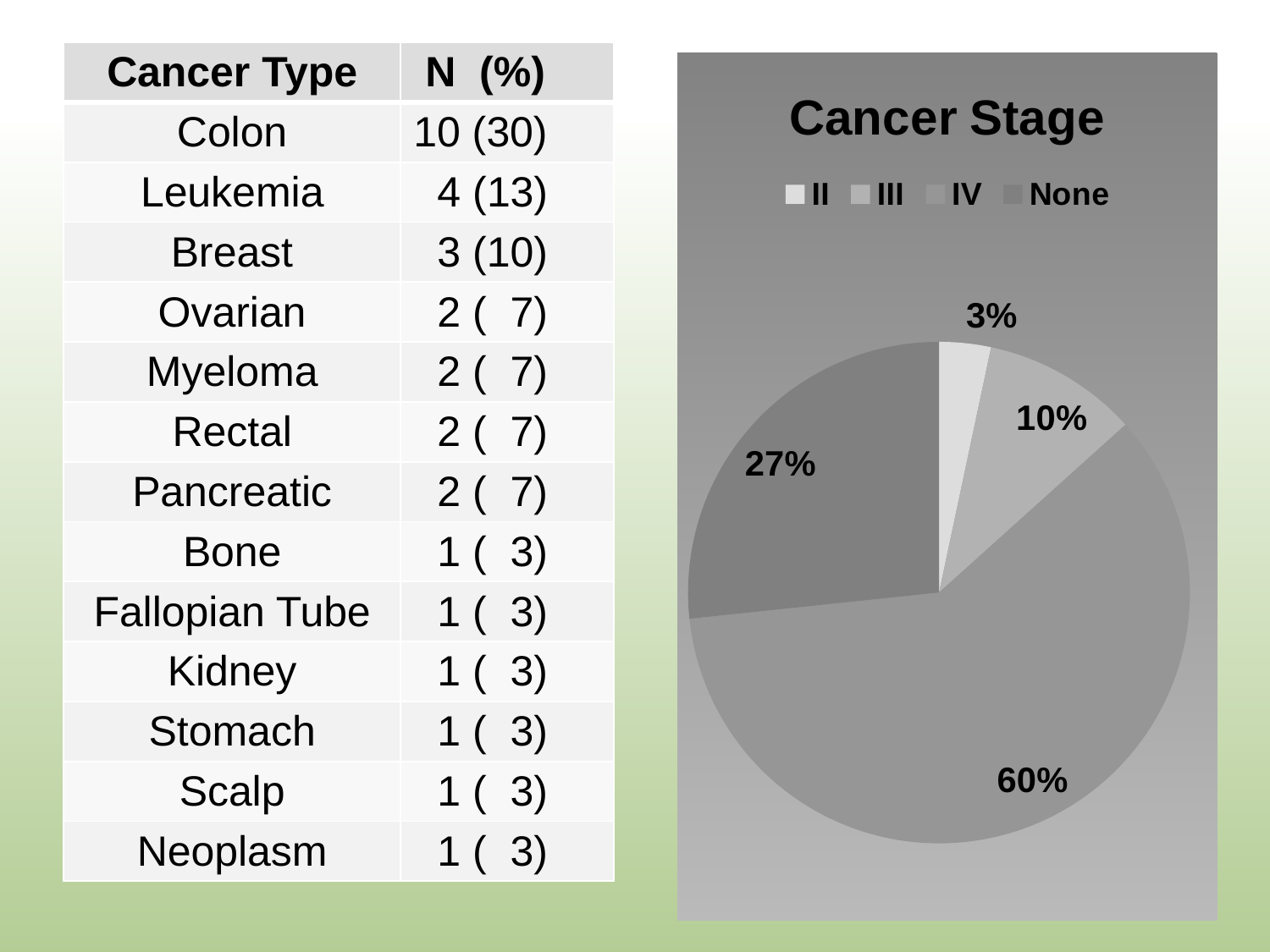
Which category has the smallest slice in the Cancer Stage pie chart? II What is the title of the chart? Cancer Stage What share of the Cancer Stage pie chart is stage II? 3% What share of the Cancer Stage pie chart is stage IV? 60% How many categories does the legend of the Cancer Stage pie chart list? 4 What share of the Cancer Stage pie chart is labelled None? 27% In the Cancer Stage pie chart, which slice is larger, III or None? None In the Cancer Stage pie chart, what is the difference in percentage points between the IV slice and the None slice? 33 Which category has the largest slice in the Cancer Stage pie chart? IV How many slices does the Cancer Stage pie chart have? 4 What kind of chart is shown on the slide? pie chart